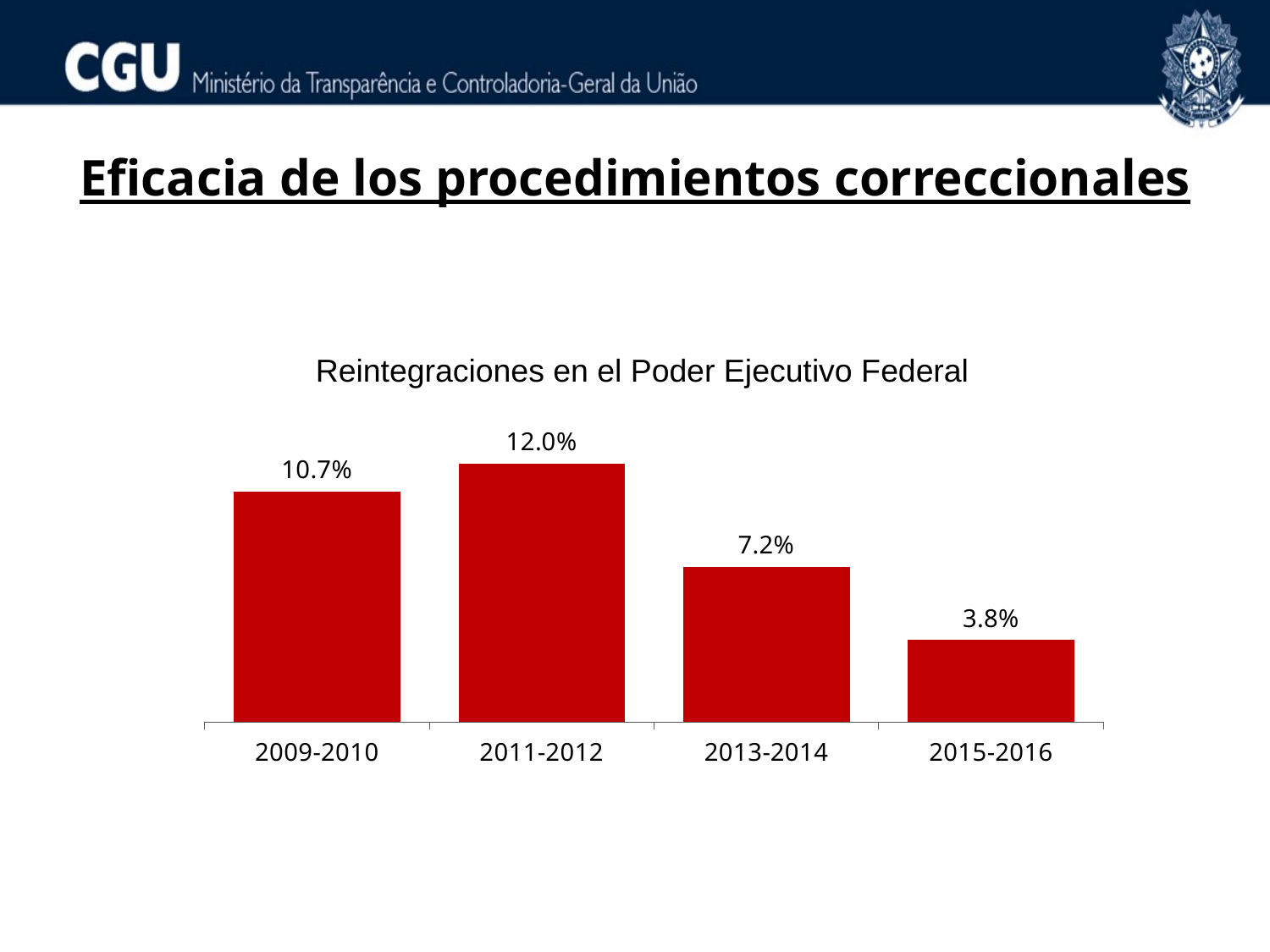
What is the value for 2013-2014? 7.2% What is the title of the chart? Reintegraciones en el Poder Ejecutivo Federal What is the value for 2009-2010? 10.7% Which period has the highest value? 2011-2012 What kind of chart is shown? Bar chart What is the value for 2011-2012? 12.0% What is the difference between the values for 2009-2010 and 2013-2014? 3.5% Which period has the lowest value? 2015-2016 How many periods are shown on the chart? 4 What is the difference between the values for 2011-2012 and 2015-2016? 8.2% Which is larger, the value for 2009-2010 or the value for 2013-2014? 2009-2010 What is the value for 2015-2016? 3.8%